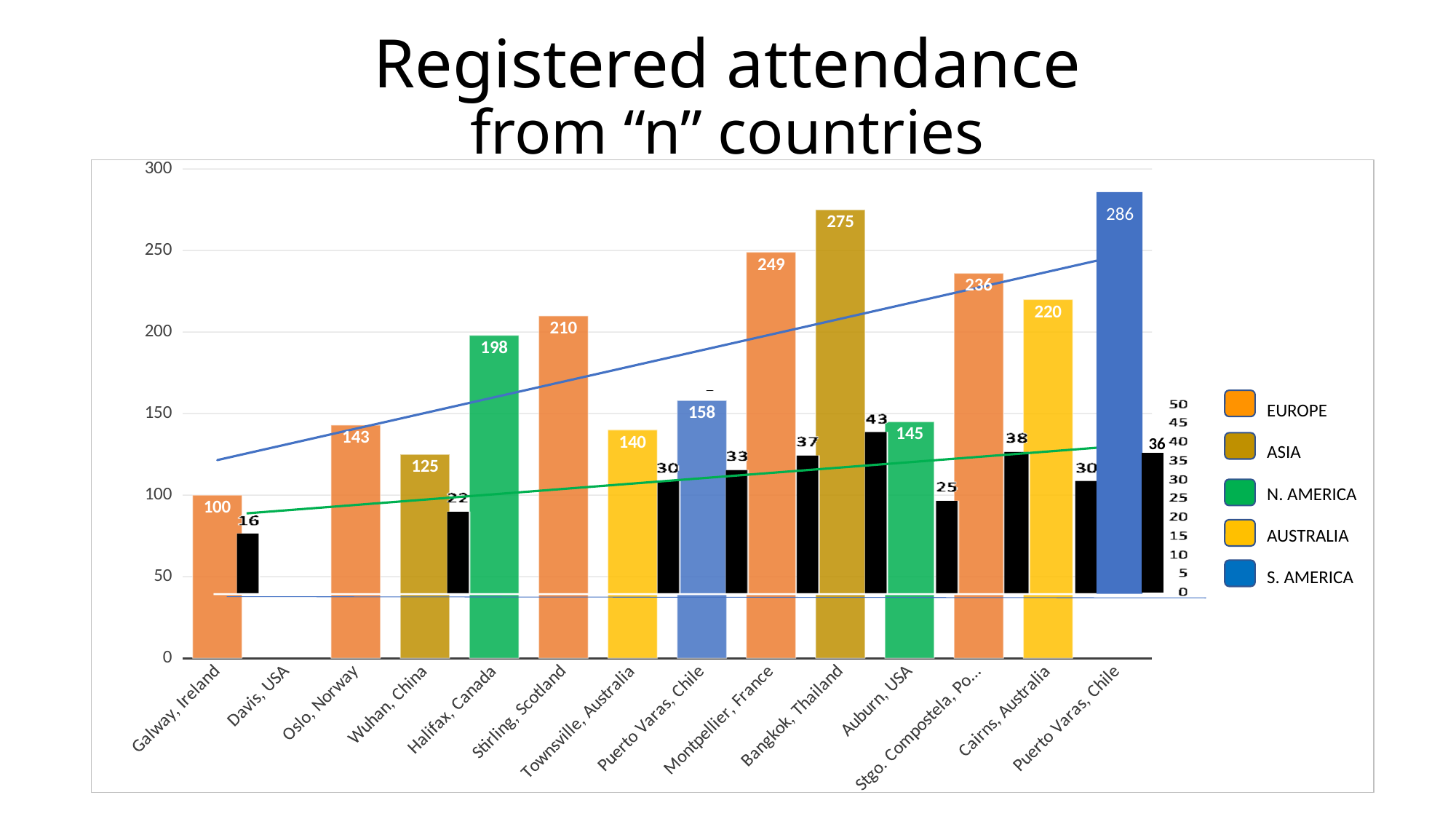
What is the registered attendance for Halifax, Canada? 198 Is the registered attendance for Oslo, Norway greater or less than 150? less How many series does the legend list? 5 Which legend entry is shown in green? N. AMERICA Which has the larger registered attendance, Stgo. Compostela or Cairns, Australia? Stgo. Compostela Which location has the lowest registered attendance among the coloured bars? Galway, Ireland Which location has the highest registered attendance? Puerto Varas, Chile (rightmost bar, 286) What is the registered attendance for Bangkok, Thailand? 275 What is the registered attendance for Montpellier, France? 249 What is the registered attendance for Cairns, Australia? 220 What is the difference in registered attendance between Bangkok, Thailand and Montpellier, France? 26 What kind of chart is shown on the slide? bar chart